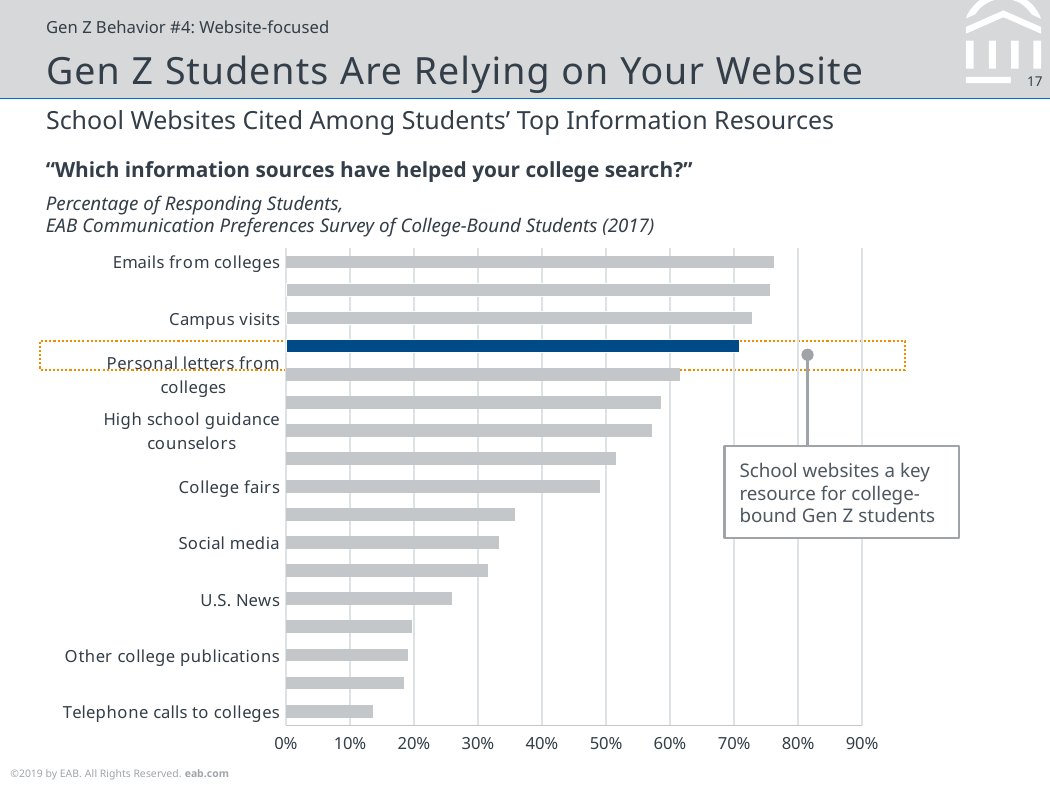
Which is larger, the value for Campus visits or the value for Social media? Campus visits How many bars are plotted in the chart? 17 Is the value for Emails from colleges greater or less than 70%? greater Is the value for Campus visits greater or less than 60%? greater Is the value for U.S. News greater or less than 30%? less What kind of chart is shown on the slide? Bar chart Which information source has the lowest percentage of responding students? Telephone calls to colleges Which information source has the highest percentage of responding students? Emails from colleges